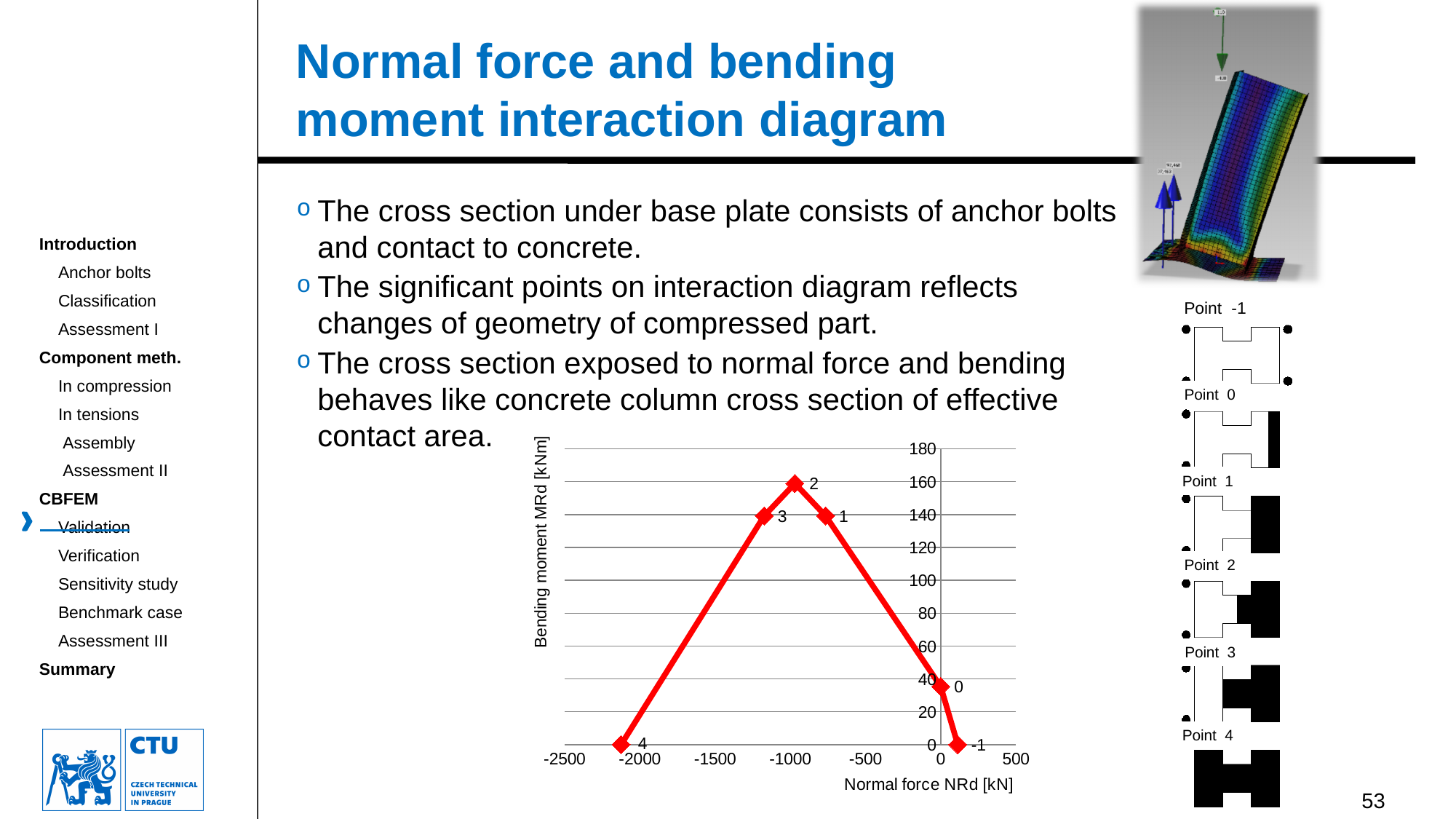
Is the normal force at point 1 greater or less than -1000? greater Is the normal force at point 4 greater or less than -2000? less What is the title of the y axis of the chart? Bending moment MRd [kNm] What is the title of the x axis of the chart? Normal force NRd [kN] What kind of chart is shown on the slide? line chart Which has the larger bending moment, point 2 or point 0? point 2 Moving from left to right along the x axis, how does the bending moment change? rises then falls Is the bending moment at point 3 greater or less than 120? greater How many labelled points are plotted on the chart? 6 Which labelled point has the highest bending moment on the chart? 2